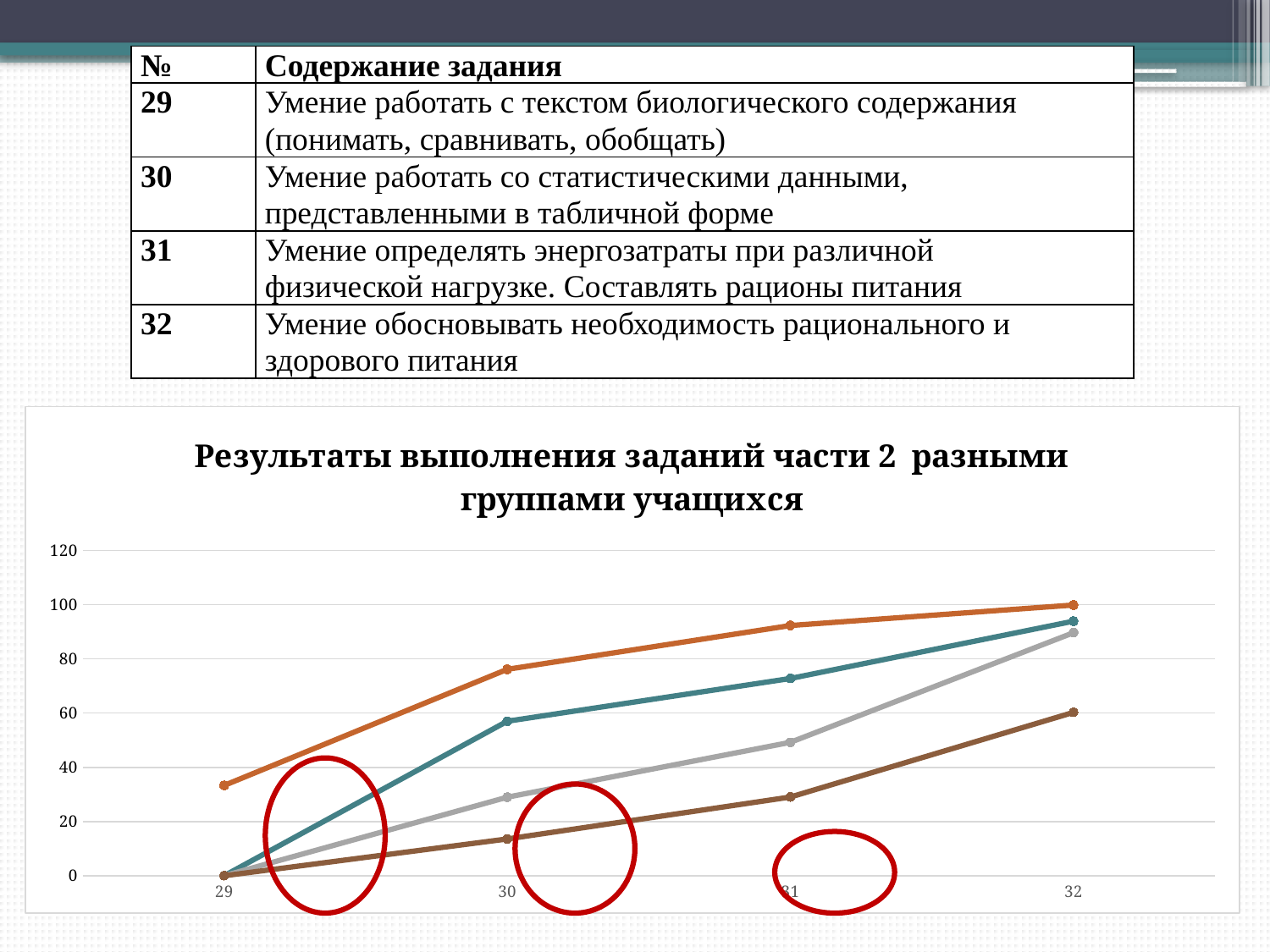
What is the title of the chart? Результаты выполнения заданий части 2 разными группами учащихся What is the value of the brown line at category 29? 0 At which category does the orange line have its lowest value? 29 Is the value of the brown line at category 32 greater or less than 80? less Is the value of the gray line at category 30 greater or less than 40? less What kind of chart is shown on the slide? line chart Is the value of the orange line at category 30 greater or less than 60? greater Does the orange line rise or fall from category 29 to category 32? rise At category 31, which line has the larger value, the orange line or the brown line? orange line At which category does the brown line reach its highest value? 32 How many categories are shown on the x axis of the chart? 4